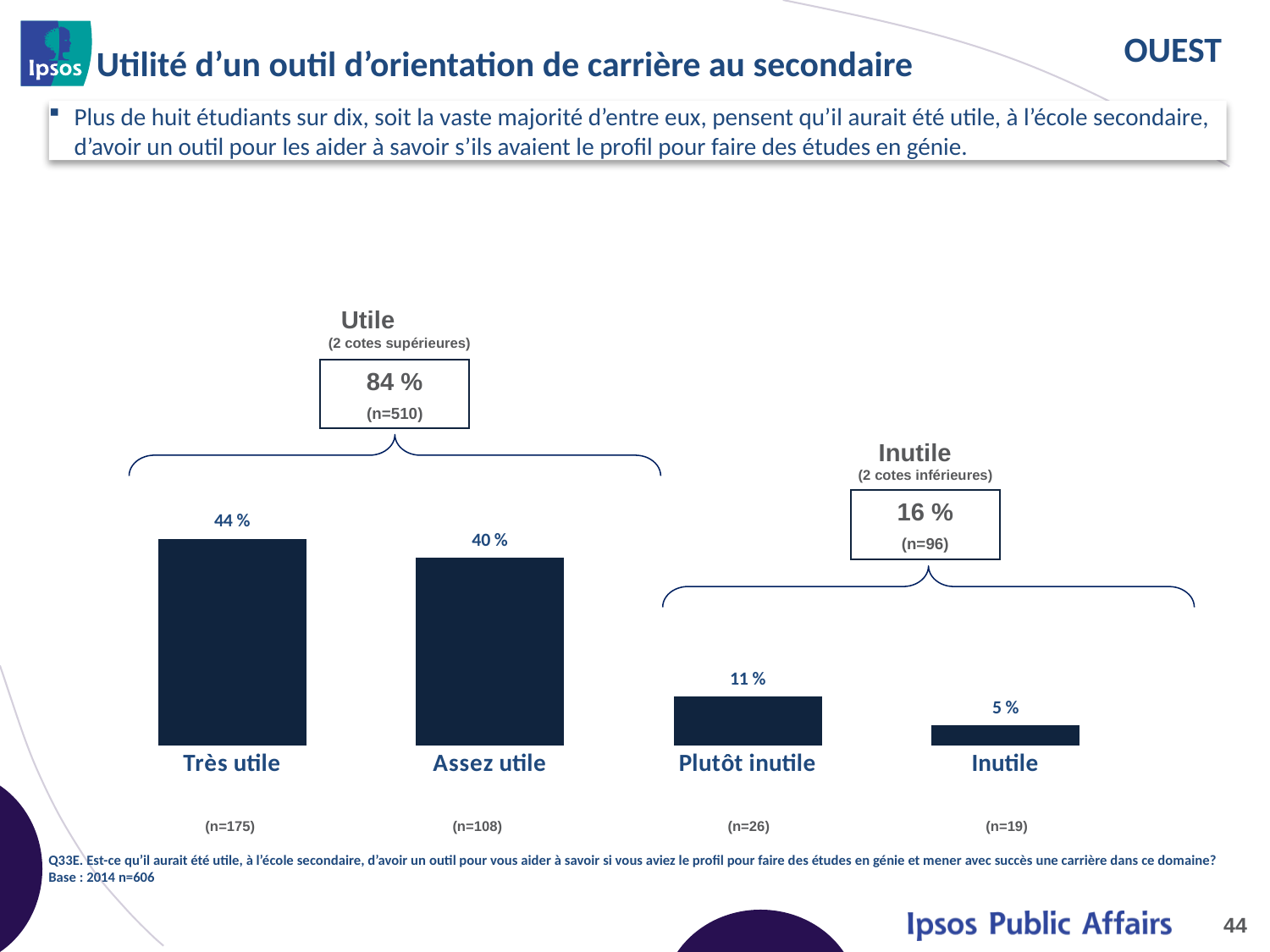
What is the difference between the values for Plutôt inutile and Inutile? 6 % What kind of chart is shown on the slide? Bar chart What is the value for Assez utile? 40 % Which is larger, the value for Assez utile or the value for Plutôt inutile? Assez utile How many categories are shown in the chart? 4 What is the difference between the values for Très utile and Assez utile? 4 % What is the value for Plutôt inutile? 11 % What is the combined value shown for the 'Utile (2 cotes supérieures)' group? 84 % Which category has the lowest value? Inutile What is the value for Très utile? 44 % What is the value for Inutile? 5 % Which category has the highest value? Très utile